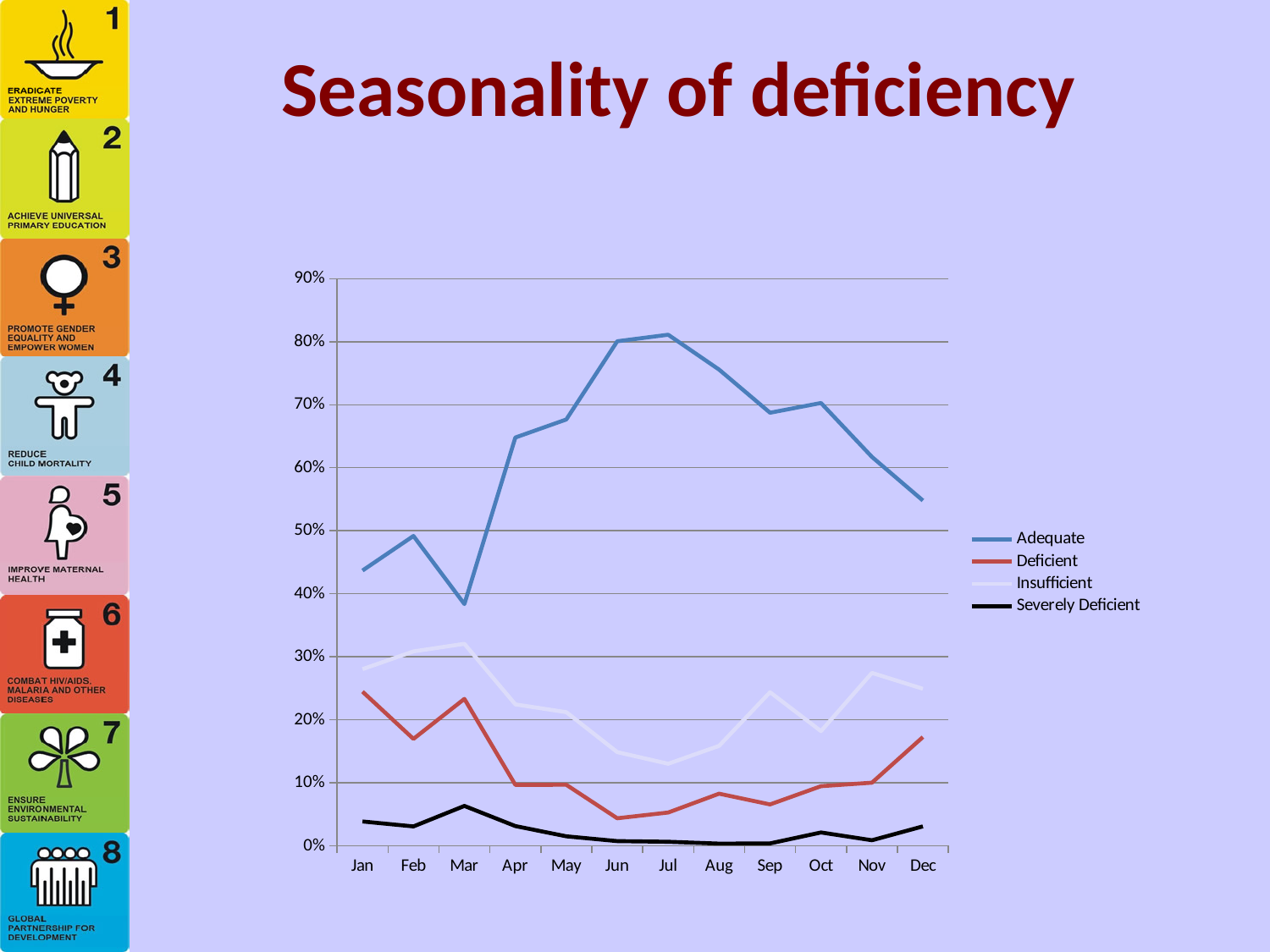
Which series has the larger value in Jul, Adequate or Deficient? Adequate In which month is the Adequate series at its lowest? Mar In which month is the Insufficient series at its lowest? Jul How many series does the legend list? 4 How many months are plotted along the x axis? 12 Is the value for Adequate in Mar greater or less than 40%? less What kind of chart is shown on the slide? line chart What is the title of the chart slide? Seasonality of deficiency Is the value for Adequate in Jun greater or less than 70%? greater In which month is the Severely Deficient series at its highest? Mar Does the Adequate series rise or fall from Jul to Dec? fall Is the value for Deficient in Jan greater or less than 20%? greater